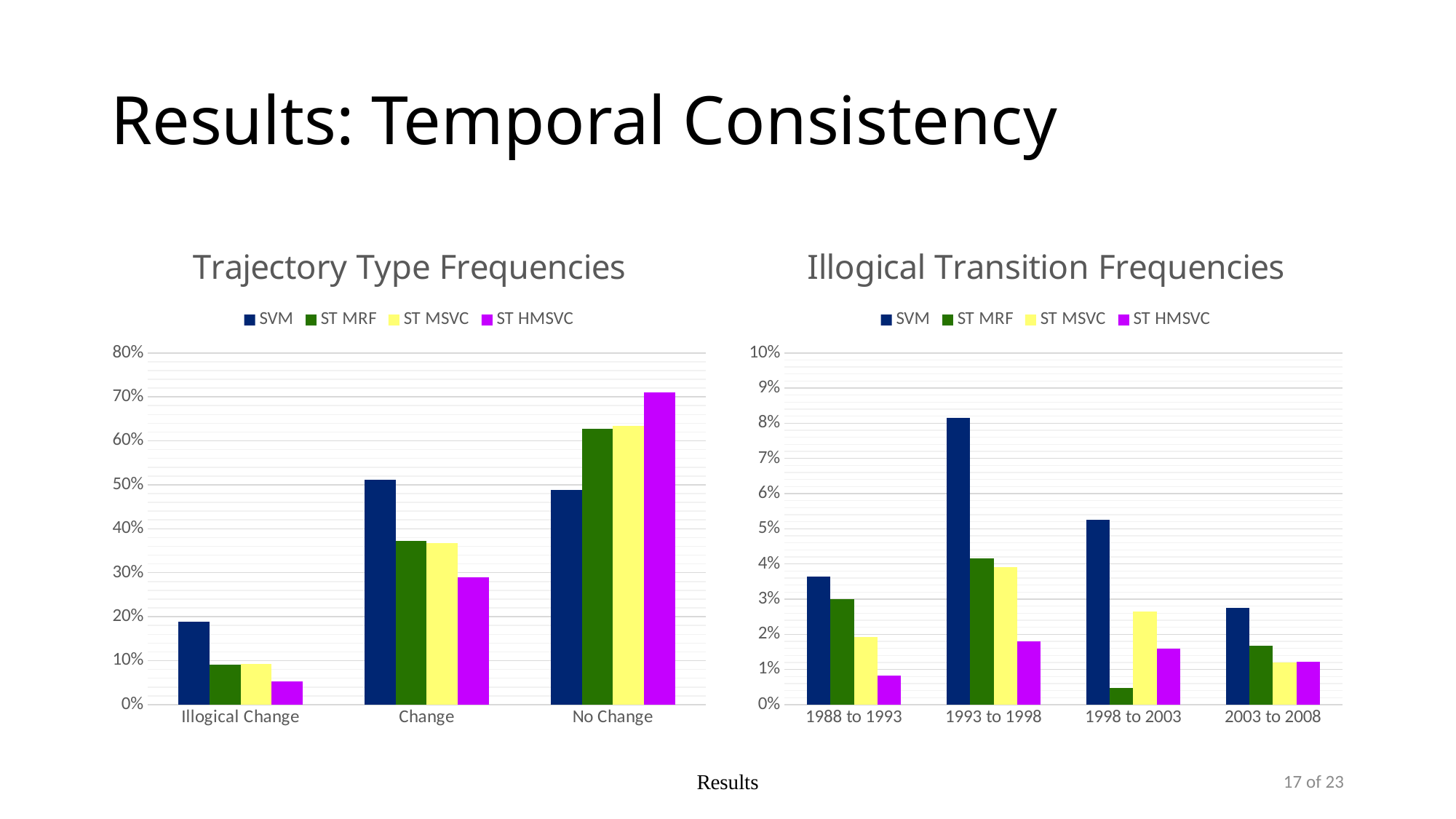
In the Trajectory Type Frequencies chart, do the ST HMSVC values rise or fall from Illogical Change to No Change? rise How many categories are shown on the x axis of the Trajectory Type Frequencies chart? 3 How many series does the legend of the Illogical Transition Frequencies chart list? 4 In the Illogical Transition Frequencies chart, is the SVM value for 1993 to 1998 greater or less than 7%? greater How many time periods are shown on the x axis of the Illogical Transition Frequencies chart? 4 In the Trajectory Type Frequencies chart, which series has the highest value for No Change? ST HMSVC In the Trajectory Type Frequencies chart, is the SVM value for Illogical Change greater or less than 10%? greater In the Illogical Transition Frequencies chart, which is larger for 1988 to 1993: SVM or ST MRF? SVM In the Illogical Transition Frequencies chart, which time period has the highest SVM value? 1993 to 1998 In the Illogical Transition Frequencies chart, is the ST MRF value for 1998 to 2003 greater or less than 1%? less In the Illogical Transition Frequencies chart, which series has the lowest value for 1998 to 2003? ST MRF What kind of chart is the Trajectory Type Frequencies chart? bar chart